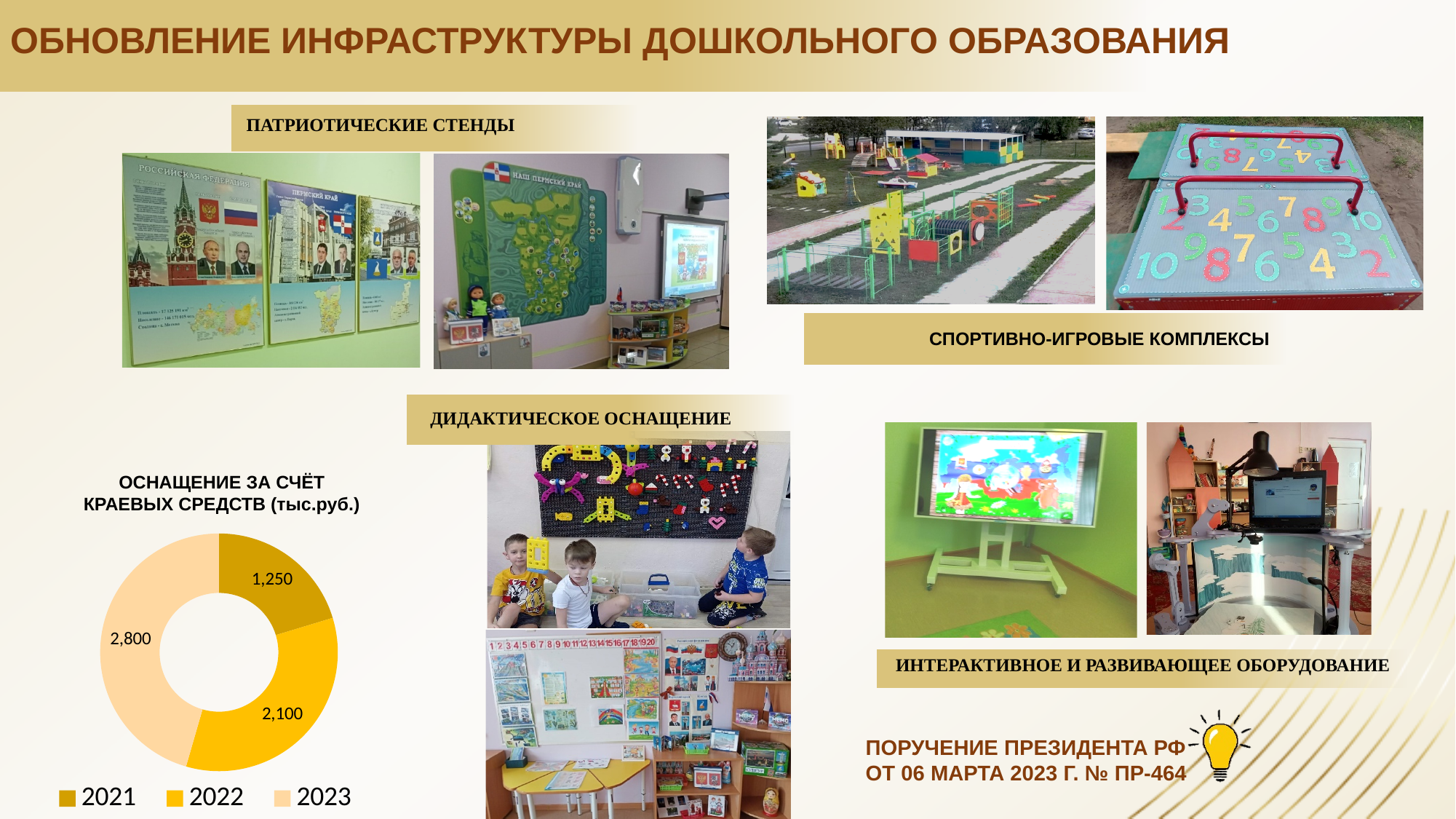
What entries does the legend of the chart 'ОСНАЩЕНИЕ ЗА СЧЁТ КРАЕВЫХ СРЕДСТВ (тыс.руб.)' list? 2021, 2022, 2023 In the chart 'ОСНАЩЕНИЕ ЗА СЧЁТ КРАЕВЫХ СРЕДСТВ (тыс.руб.)', what is the difference between the values for 2022 and 2021? 850 What is the value for 2023 in the chart 'ОСНАЩЕНИЕ ЗА СЧЁТ КРАЕВЫХ СРЕДСТВ (тыс.руб.)'? 2,800 What kind of chart is 'ОСНАЩЕНИЕ ЗА СЧЁТ КРАЕВЫХ СРЕДСТВ (тыс.руб.)'? doughnut chart Do the values in the chart 'ОСНАЩЕНИЕ ЗА СЧЁТ КРАЕВЫХ СРЕДСТВ (тыс.руб.)' rise or fall from 2021 to 2023? rise What is the value for 2021 in the chart 'ОСНАЩЕНИЕ ЗА СЧЁТ КРАЕВЫХ СРЕДСТВ (тыс.руб.)'? 1,250 Which year has the lowest value in the chart 'ОСНАЩЕНИЕ ЗА СЧЁТ КРАЕВЫХ СРЕДСТВ (тыс.руб.)'? 2021 What is the value for 2022 in the chart 'ОСНАЩЕНИЕ ЗА СЧЁТ КРАЕВЫХ СРЕДСТВ (тыс.руб.)'? 2,100 In the chart 'ОСНАЩЕНИЕ ЗА СЧЁТ КРАЕВЫХ СРЕДСТВ (тыс.руб.)', which is larger: the value for 2022 or the value for 2023? 2023 In the chart 'ОСНАЩЕНИЕ ЗА СЧЁТ КРАЕВЫХ СРЕДСТВ (тыс.руб.)', what is the difference between the values for 2023 and 2021? 1,550 How many years (categories) are shown in the chart 'ОСНАЩЕНИЕ ЗА СЧЁТ КРАЕВЫХ СРЕДСТВ (тыс.руб.)'? 3 Which year has the highest value in the chart 'ОСНАЩЕНИЕ ЗА СЧЁТ КРАЕВЫХ СРЕДСТВ (тыс.руб.)'? 2023